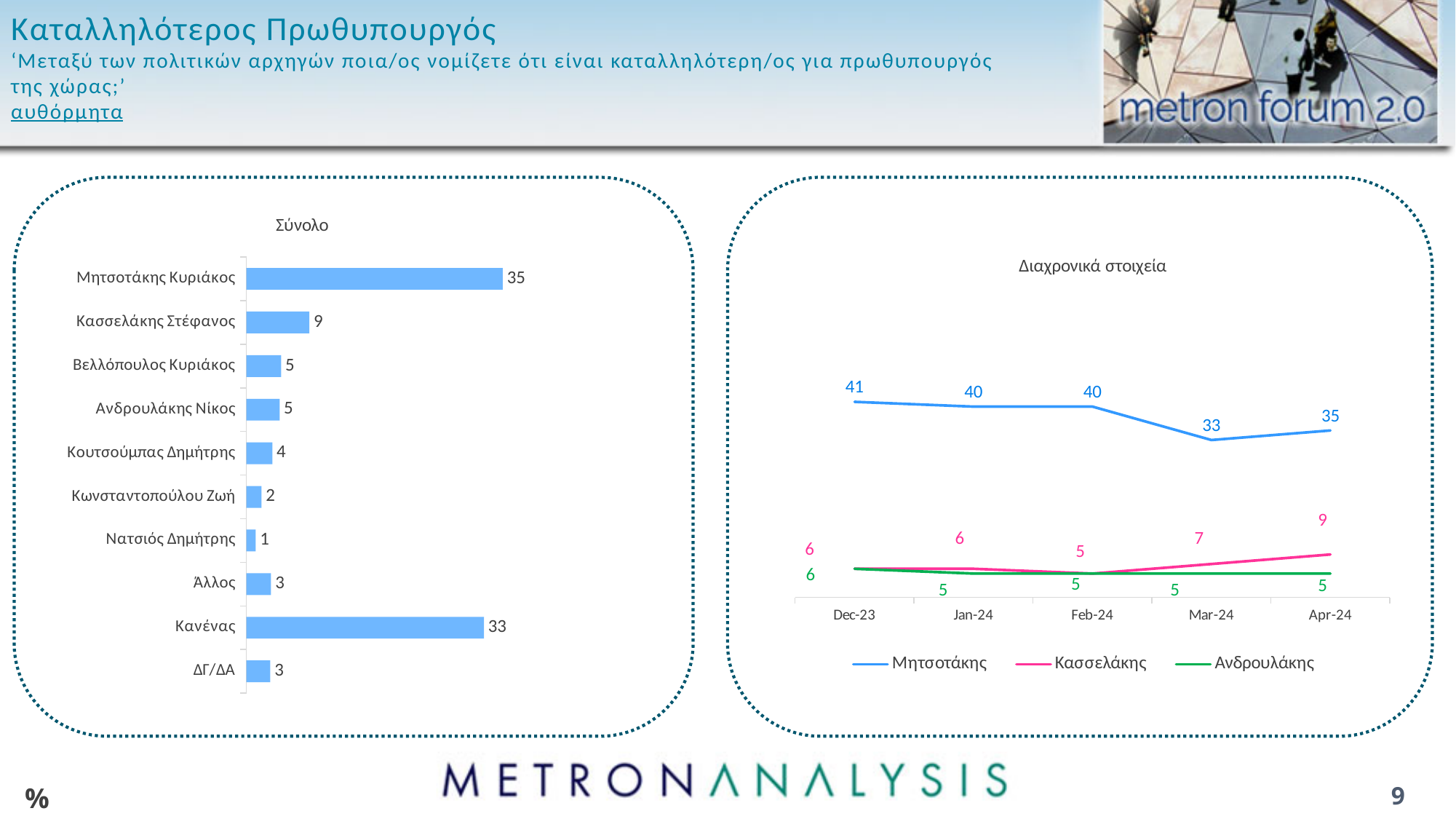
In the 'Σύνολο' chart, what is the value for Κανένας? 33 In the 'Διαχρονικά στοιχεία' chart, what is the value for Μητσοτάκης in Mar-24? 33 In the 'Διαχρονικά στοιχεία' chart, how many series does the legend list? 3 In the 'Σύνολο' chart, which category has the lowest value? Νατσιός Δημήτρης In the 'Σύνολο' chart, what is the difference between Μητσοτάκης Κυριάκος and Κασσελάκης Στέφανος? 26 What kind of chart is the 'Διαχρονικά στοιχεία' chart? Line chart In the 'Διαχρονικά στοιχεία' chart, does the Μητσοτάκης line rise or fall from Dec-23 to Mar-24? Fall What kind of chart is the 'Σύνολο' chart? Bar chart In the 'Διαχρονικά στοιχεία' chart, which is larger in Apr-24: Κασσελάκης or Ανδρουλάκης? Κασσελάκης In the 'Σύνολο' chart, how many categories are shown? 10 In the 'Διαχρονικά στοιχεία' chart, what is the value for Κασσελάκης in Apr-24? 9 In the 'Σύνολο' chart, what is the value for Μητσοτάκης Κυριάκος? 35